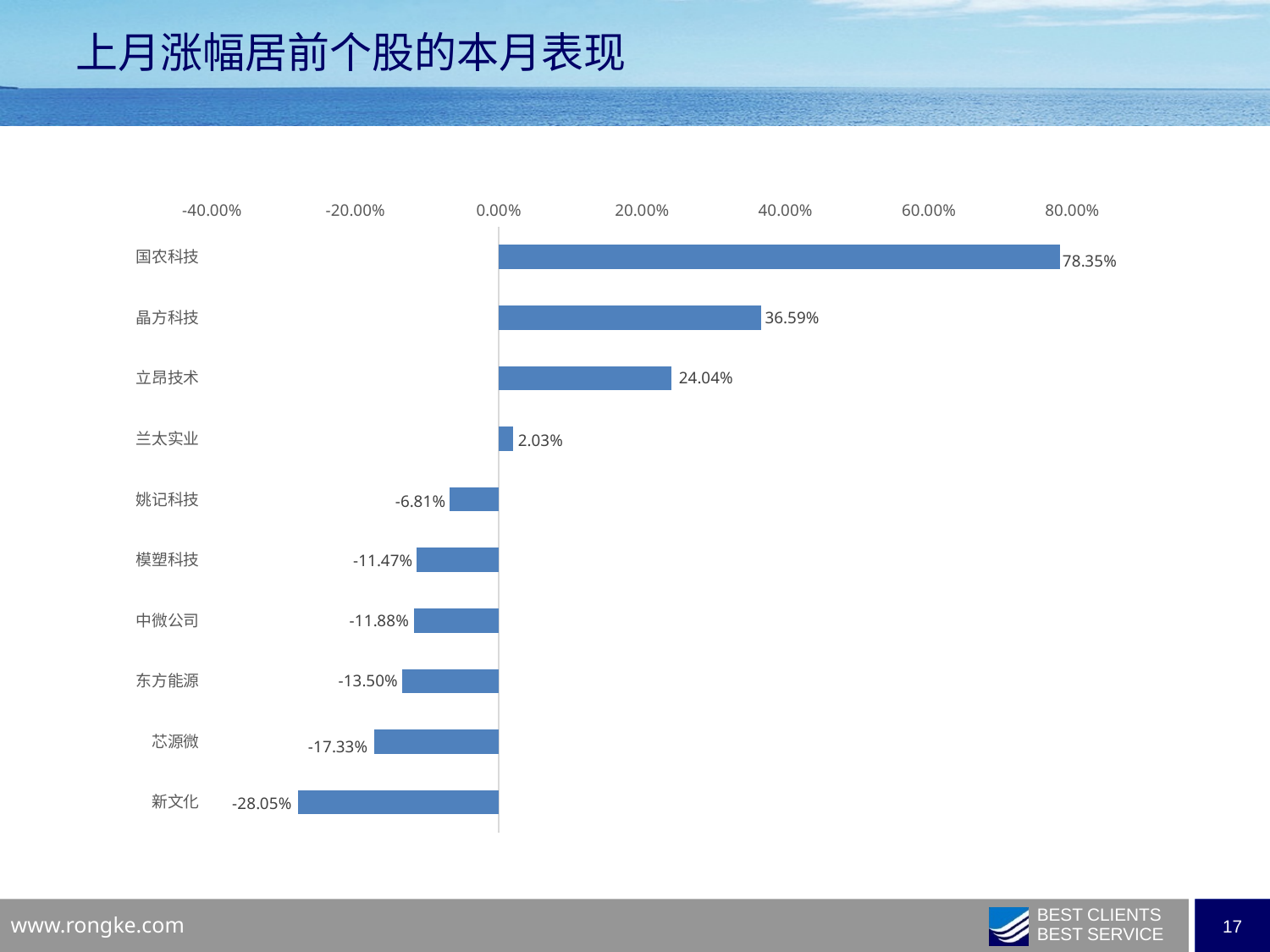
What is the value for 兰太实业? 2.03% How many stocks are shown in the chart? 10 Which stock has the highest value? 国农科技 How many stocks have a negative value? 6 What kind of chart is shown on the slide? bar chart What is the value for 中微公司? -11.88% What is the value for 国农科技? 78.35% Which is larger, the value for 姚记科技 or the value for 芯源微? 姚记科技 Is the value for 晶方科技 greater or less than 20.00%? greater What is the difference between the values for 晶方科技 and 立昂技术? 12.55% Which stock has the lowest value? 新文化 What is the title of the slide? 上月涨幅居前个股的本月表现